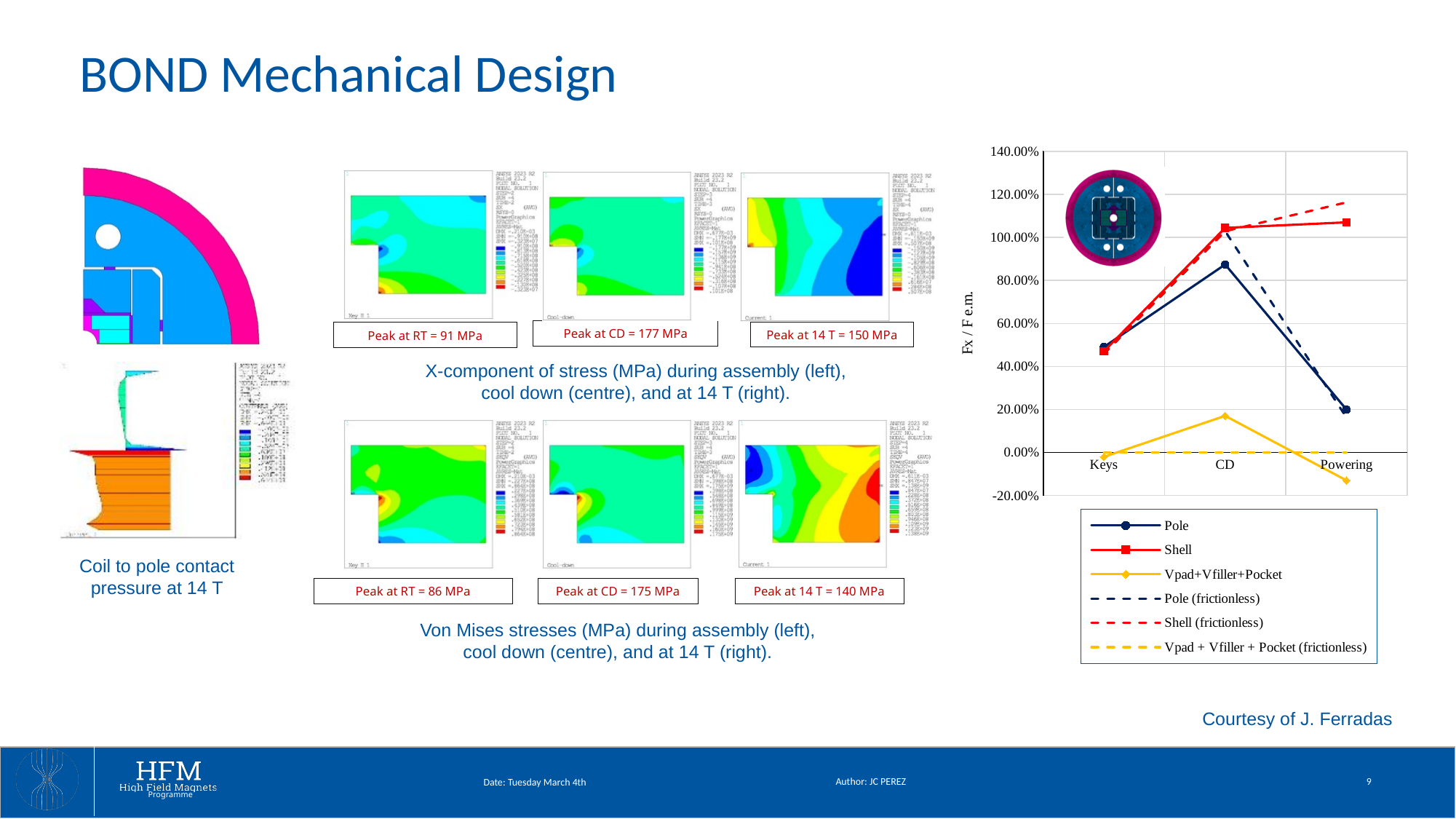
In the line chart, is the value of the Pole series at Powering greater or less than 40.00%? less In the line chart legend, which series is drawn in yellow with a solid line? Vpad+Vfiller+Pocket In the line chart, at Powering, which series has the larger value: Shell or Pole? Shell How many series does the legend of the line chart list? 6 What kind of chart is shown on the right of the slide? line chart What is the label on the y axis of the line chart? Fx / F e.m. How many categories are shown on the x axis of the line chart? 3 In the line chart, is the value of the Shell series at CD greater or less than 100.00%? greater In the line chart, at which category does the Vpad+Vfiller+Pocket series have its lowest value? Powering In the line chart, at which category does the Pole series reach its highest value? CD In the line chart, is the value of the Vpad+Vfiller+Pocket series at CD greater or less than 40.00%? less In the line chart, does the Pole series rise or fall from CD to Powering? fall